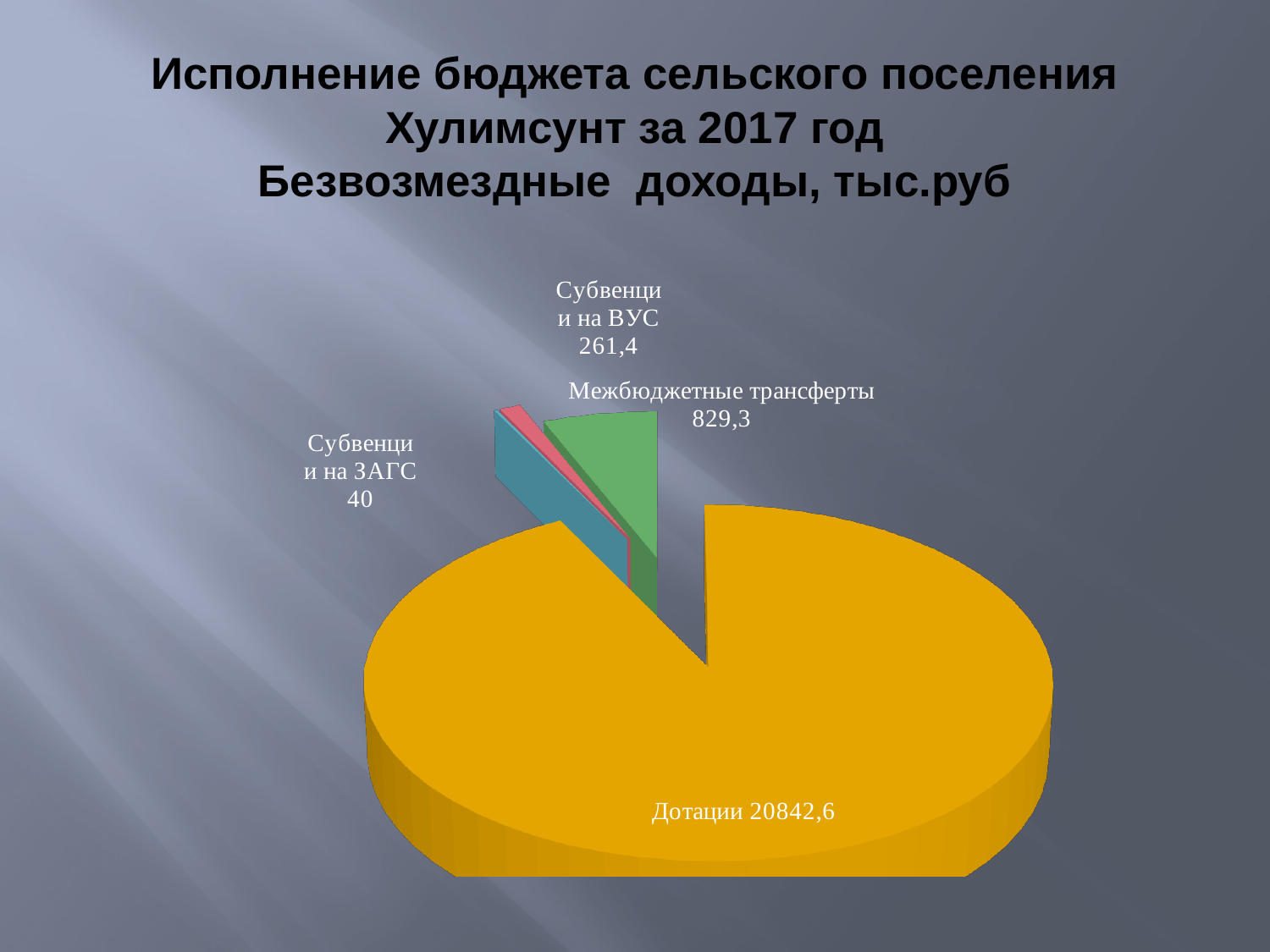
What is the value for Субвенции на ЗАГС? 40 What is the difference between Субвенции на ВУС and Субвенции на ЗАГС? 221,4 How many slices does the pie chart have? 4 Which is larger, Межбюджетные трансферты or Субвенции на ВУС? Межбюджетные трансферты What kind of chart is shown on the slide? pie chart What is the value for Субвенции на ВУС? 261,4 What is the difference between Межбюджетные трансферты and Субвенции на ВУС? 567,9 What is the value for Дотации? 20842,6 What is the value for Межбюджетные трансферты? 829,3 Which category has the largest slice of the pie? Дотации Which category has the smallest slice of the pie? Субвенции на ЗАГС What unit is stated in the chart title for the values? тыс.руб